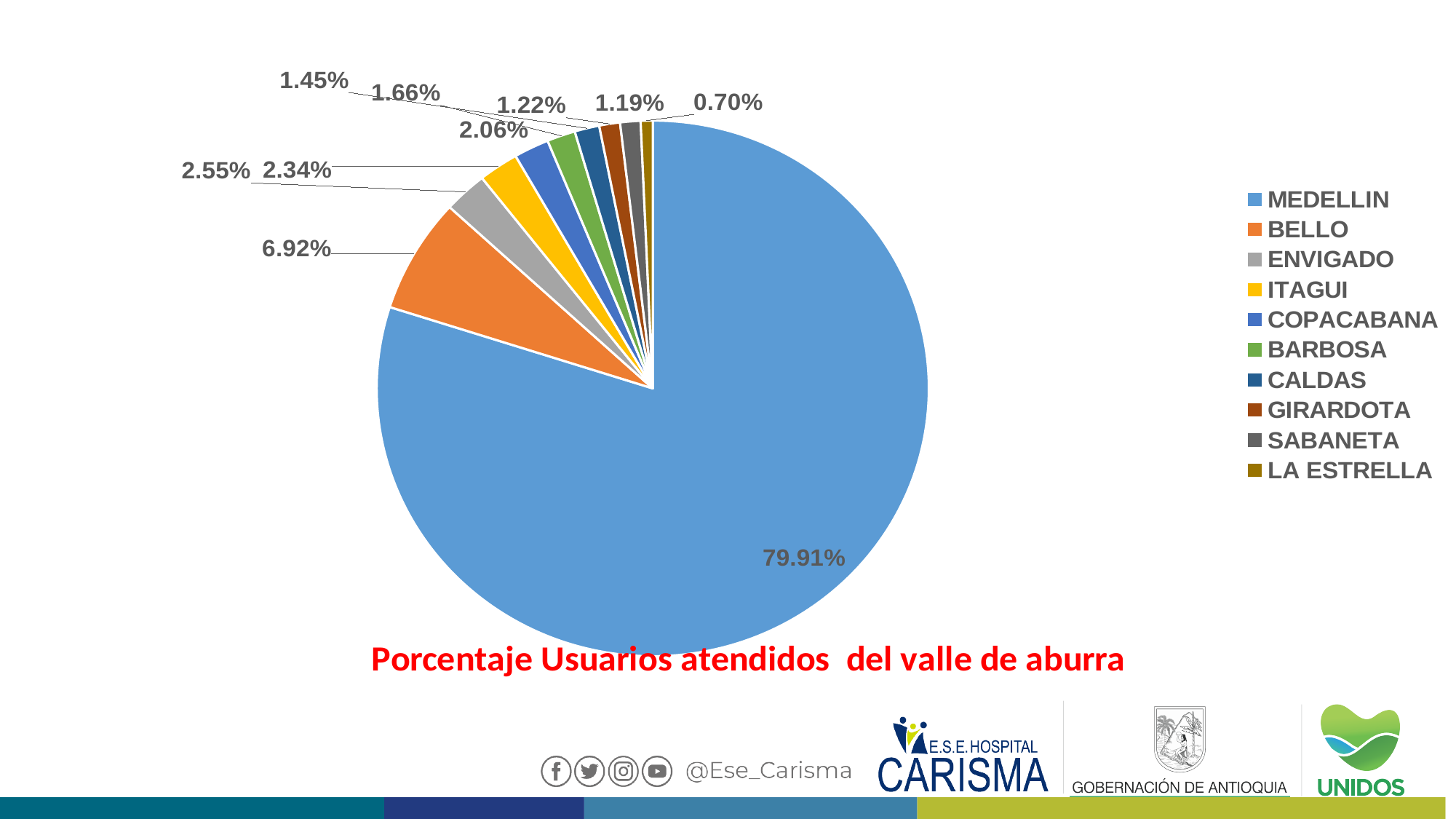
Which municipality has the largest share of the pie? MEDELLIN How many municipalities are shown in the pie chart? 10 What percentage of the pie does MEDELLIN represent? 79.91% What is the title of the chart? Porcentaje Usuarios atendidos del valle de aburra Which has a larger share, ENVIGADO or ITAGUI? ENVIGADO What is the value shown for ITAGUI? 2.34% What is the value shown for LA ESTRELLA? 0.70% What is the difference in percentage points between BELLO and ENVIGADO? 4.37% What is the value shown for BELLO? 6.92% Which municipality has the smallest share of the pie? LA ESTRELLA What is the difference in percentage points between MEDELLIN and BELLO? 72.99% What type of chart is shown on the slide? Pie chart